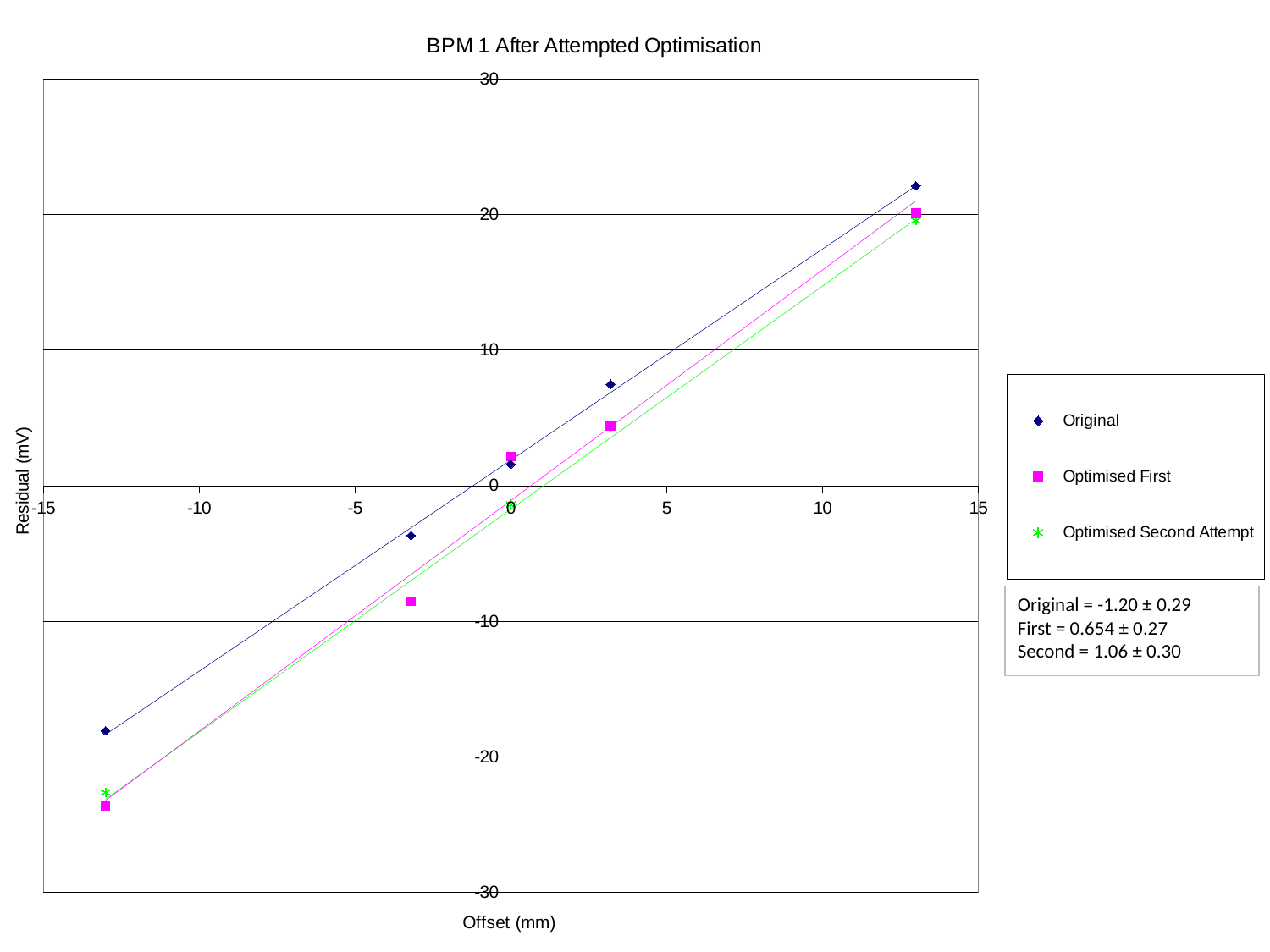
At an offset of about 13 mm, which series has the larger residual, Original or Optimised First? Original Do the Original residual values rise or fall as the offset increases along the x axis? Rise What is the title of the chart? BPM 1 After Attempted Optimisation How many series does the legend list? 3 Is the Original residual at an offset of about 13 mm greater or less than 20? greater Is the Original residual at an offset of about 3 mm greater or less than 10? less Which series contains the highest plotted residual value? Original How many data points are plotted for the Original series? 5 Is the Optimised First residual at an offset of about -13 mm greater or less than -20? less According to the text box beside the chart, what is the value given for Original? -1.20 ± 0.29 What kind of chart is shown on the slide? Scatter chart